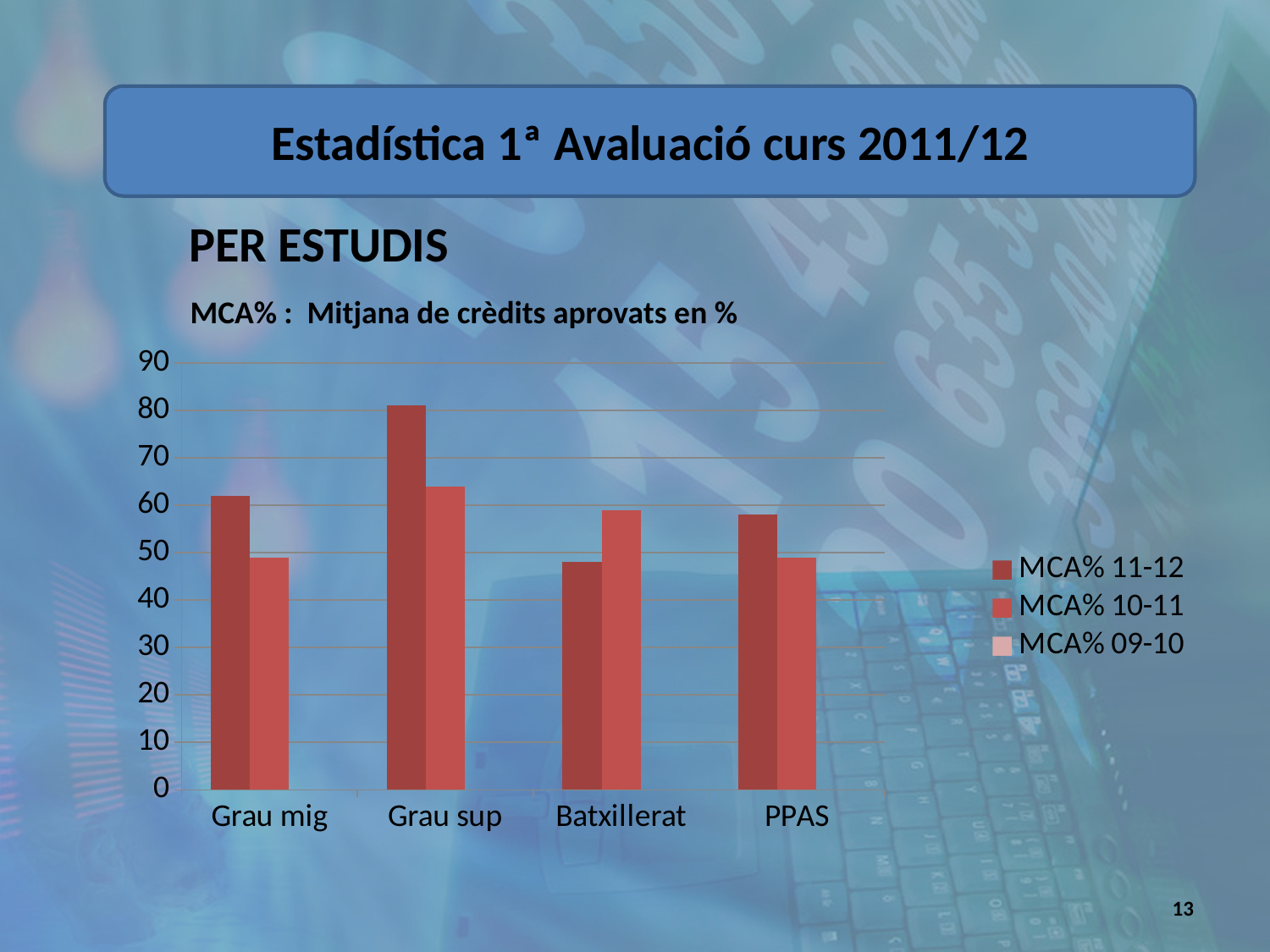
For Batxillerat, which is larger: MCA% 11-12 or MCA% 10-11? MCA% 10-11 What kind of chart is shown on the slide? bar chart Which category has the lowest value for MCA% 11-12? Batxillerat What does MCA% stand for according to the text above the chart? Mitjana de crèdits aprovats en % Is the value for MCA% 11-12 in Grau mig greater or less than 60? greater How many series does the chart's legend list? 3 For PPAS, which is larger: MCA% 11-12 or MCA% 10-11? MCA% 11-12 Which category has the highest value for MCA% 10-11? Grau sup How many categories are shown on the x axis of the chart? 4 Which category has the highest value for MCA% 11-12? Grau sup